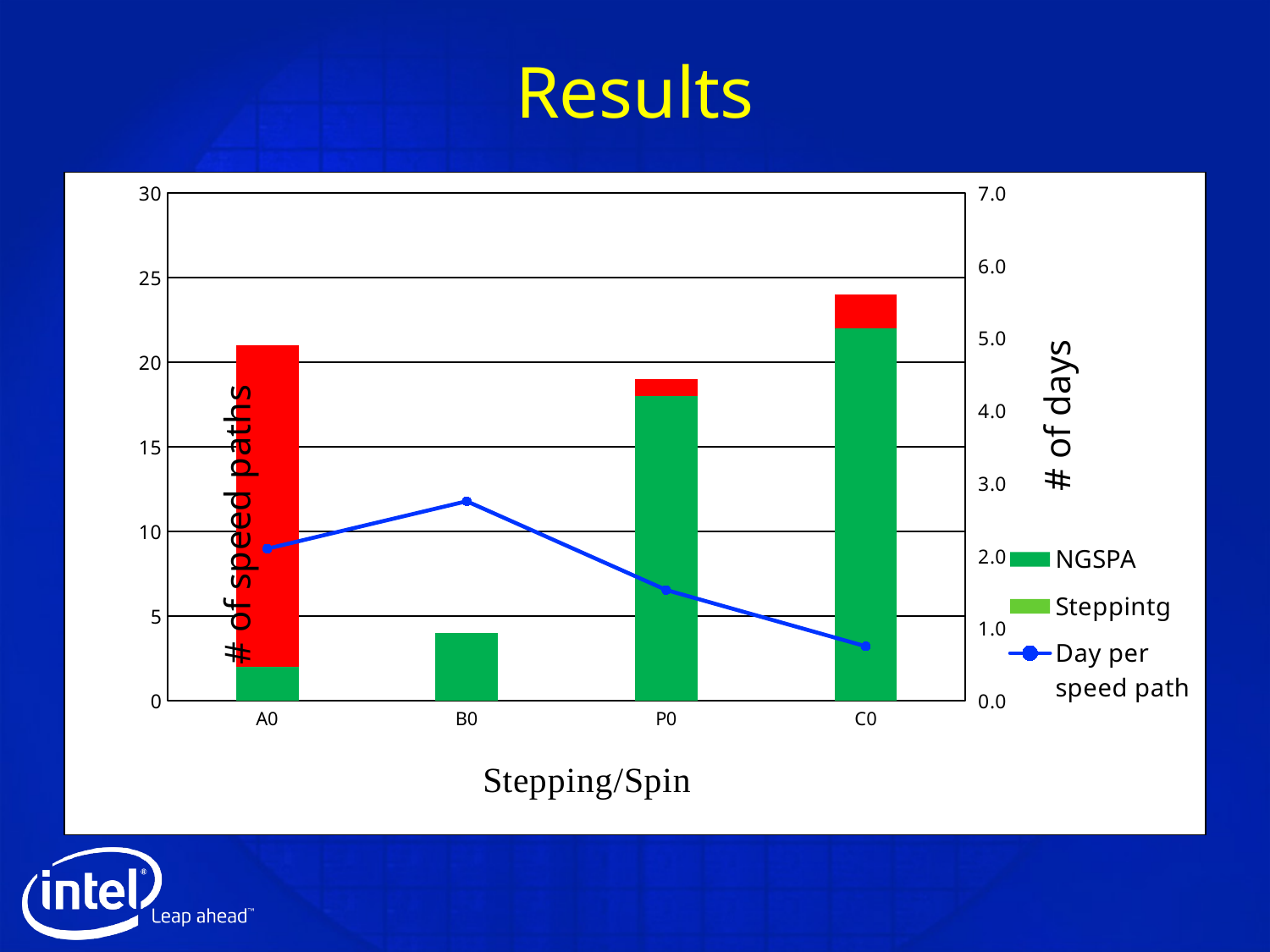
How many series does the legend list? 3 How many categories are shown on the x axis? 4 Is the bar value for B0 greater or less than 5? less Is the Day per speed path value at C0 greater or less than 1.0? less Is the total stacked bar for A0 greater or less than 20? greater What kind of chart is shown on the slide? A bar chart combined with a line series At which category does the Day per speed path line reach its highest point? B0 Which category has the tallest stacked bar? C0 Which has the larger NGSPA value, A0 or P0? P0 Does the Day per speed path line rise or fall from B0 to C0? fall Which category has the shortest stacked bar? B0